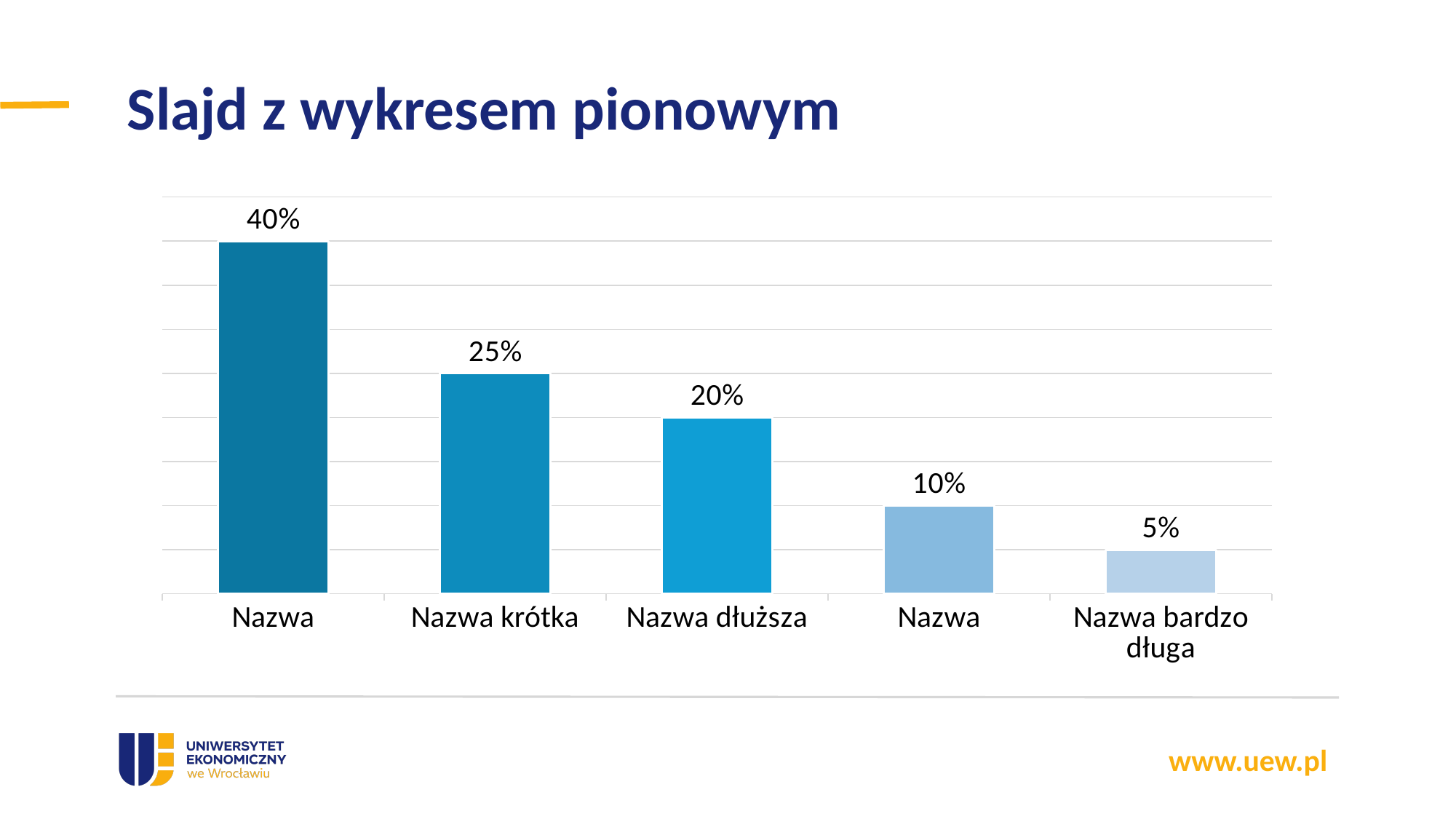
Which category has the highest value? Nazwa (the first bar) Do the values rise or fall from left to right along the x axis? Fall How many bars are shown in the chart? 5 Which is larger, the value for Nazwa dłuższa or Nazwa bardzo długa? Nazwa dłuższa What is the value for Nazwa krótka? 25% What is the value for Nazwa bardzo długa? 5% What is the value of the fourth bar, labelled Nazwa? 10% What kind of chart is shown on the slide? Bar chart What is the value of the first bar on the left, labelled Nazwa? 40% What is the difference between the values for Nazwa krótka and Nazwa dłuższa? 5% What is the value for Nazwa dłuższa? 20% Which category has the lowest value? Nazwa bardzo długa